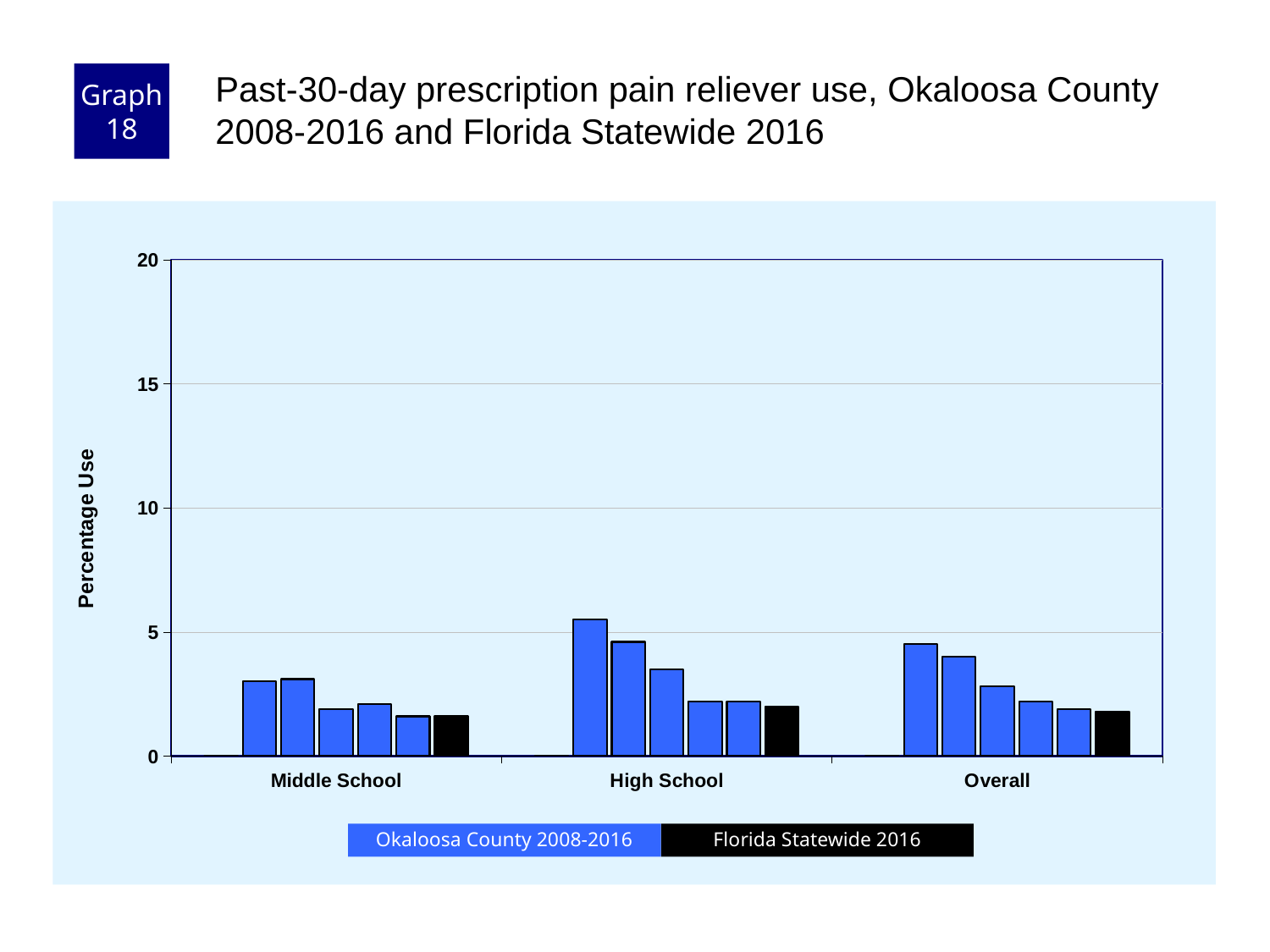
What is the label of the y axis? Percentage Use How many series does the legend list? 2 Is the tallest bar for Overall greater or less than 10? less What kind of chart is shown on the slide? bar chart Is the tallest bar for Middle School greater or less than 5? less Which category contains the tallest bar in the chart? High School Is the tallest Okaloosa County bar for High School greater or less than 5? greater How many categories are shown on the x axis? 3 Which series is shown in black in the legend? Florida Statewide 2016 Which is larger: the tallest bar for High School or the tallest bar for Middle School? High School